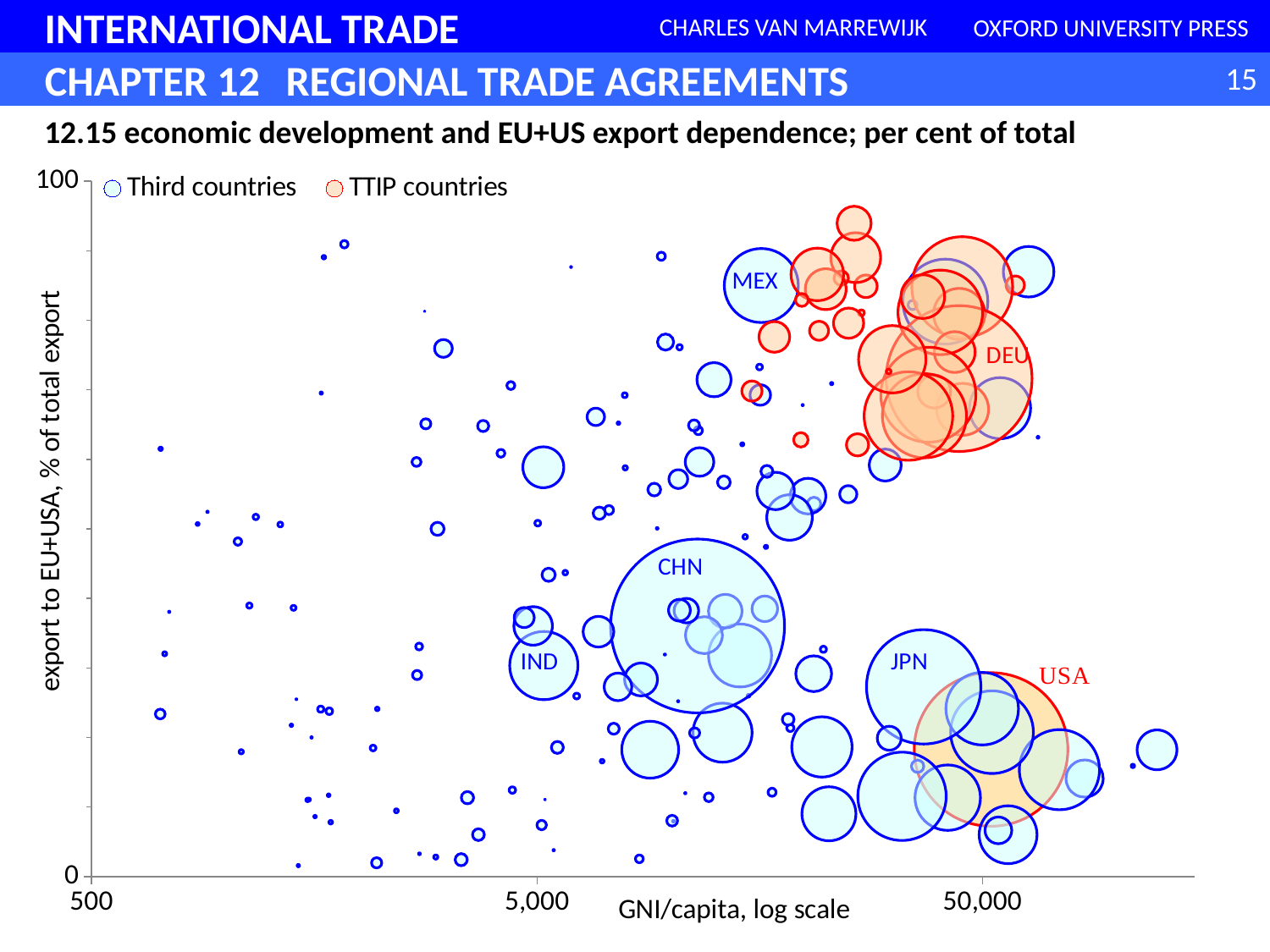
What are the two series named in the legend? Third countries and TTIP countries Is the export-to-EU+USA value for MEX greater or less than 50? greater Is the GNI/capita for CHN greater or less than 5,000? greater What is the label of the vertical axis? export to EU+USA, % of total export Is the export-to-EU+USA value for DEU greater or less than 50? greater Which has a higher export-to-EU+USA share, DEU or JPN? DEU How many series does the legend list? 2 What kind of chart is shown on the slide? bubble chart Which has a higher export-to-EU+USA share, MEX or USA? MEX